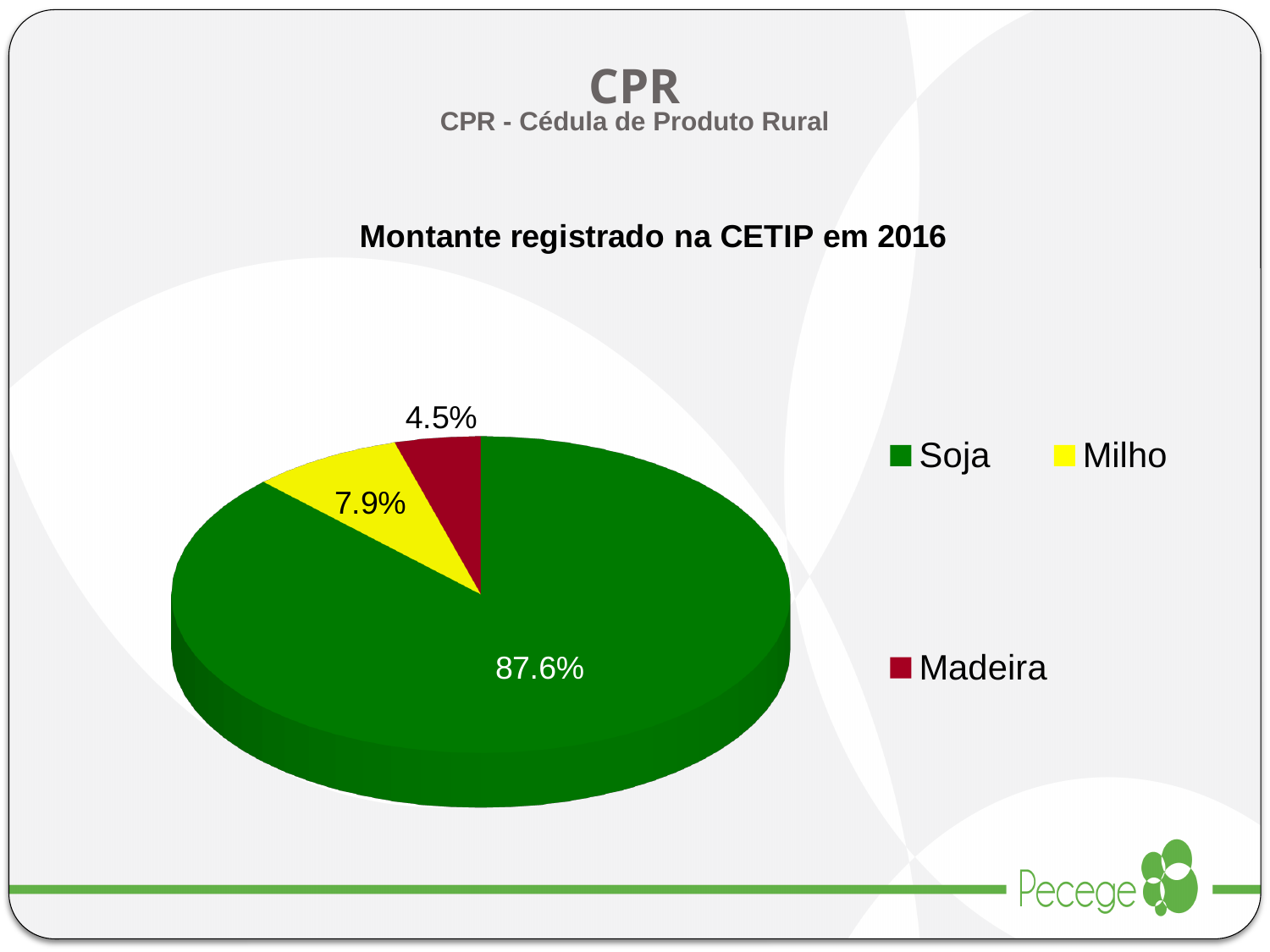
Which category has the smallest slice of the pie? Madeira What is the difference in percentage points between the Soja share and the Milho share? 79.7 Which category has the largest slice of the pie? Soja What share of the pie does Soja represent? 87.6% Which is larger, the share for Milho or the share for Madeira? Milho What share of the pie does Madeira represent? 4.5% What colour is the slice for Madeira? dark red What is the title of the chart? Montante registrado na CETIP em 2016 What share of the pie does Milho represent? 7.9% How many categories does the pie chart show? 3 What is the difference in percentage points between the Milho share and the Madeira share? 3.4 What kind of chart is shown on the slide? pie chart